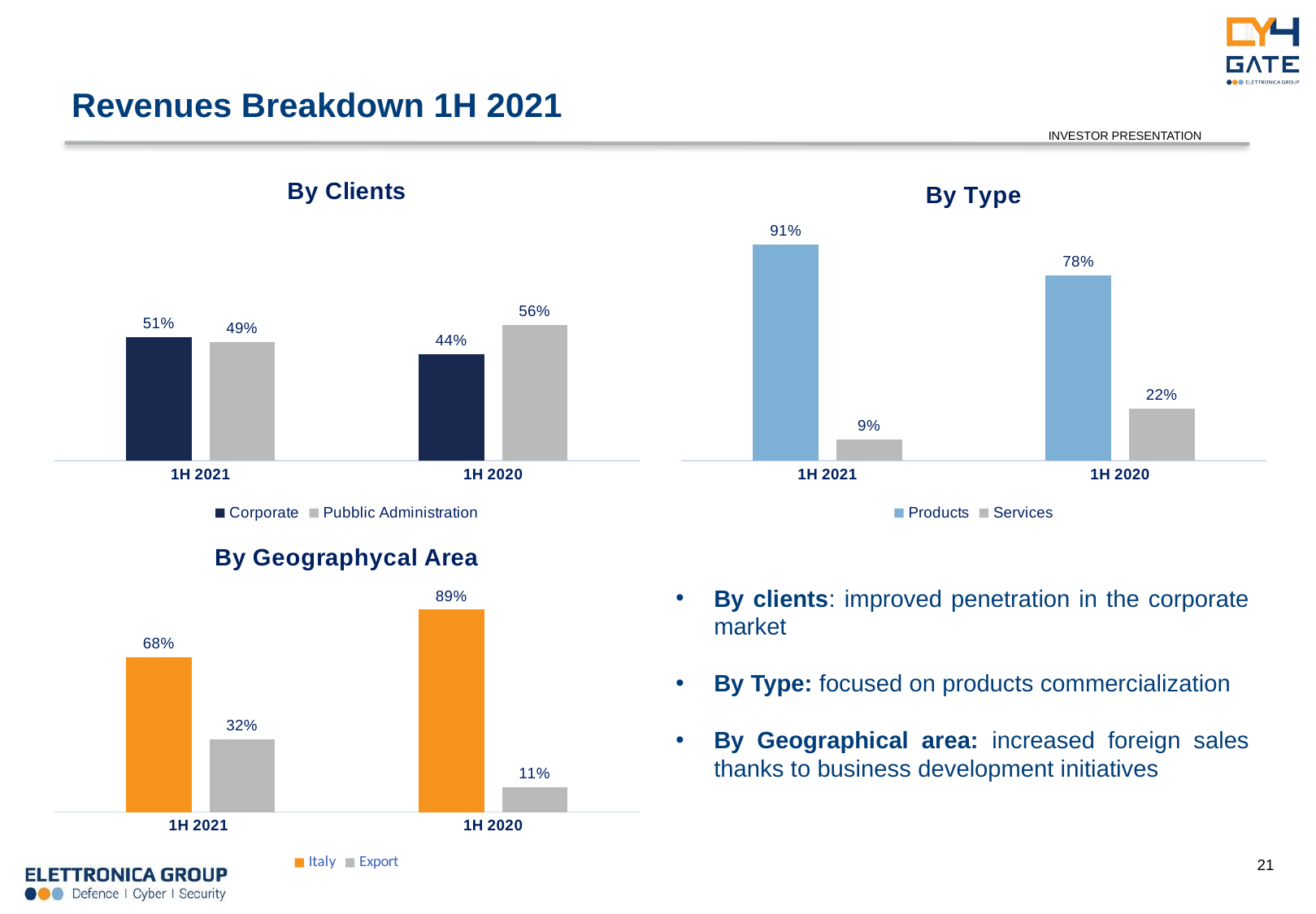
In the 'By Geographycal Area' chart, what is the Export value for 1H 2021? 32% In the 'By Type' chart, what is the Services value for 1H 2020? 22% In the 'By Type' chart, what is the Products value for 1H 2021? 91% In the 'By Geographycal Area' chart, what is the Italy value for 1H 2020? 89% In the 'By Clients' chart, what is the difference between the Pubblic Administration and Corporate values for 1H 2020? 12% In the 'By Clients' chart, what is the Corporate value for 1H 2021? 51% What kind of chart is the 'By Clients' chart? bar chart In the 'By Type' chart, how many series does the legend list? 2 In the 'By Clients' chart, what is the Pubblic Administration value for 1H 2020? 56% In the 'By Geographycal Area' chart, what is the difference between the Export values for 1H 2021 and 1H 2020? 21% In the 'By Type' chart, which series has the higher value in 1H 2021, Products or Services? Products In the 'By Geographycal Area' chart, does the Italy value rise or fall from 1H 2021 to 1H 2020? rise